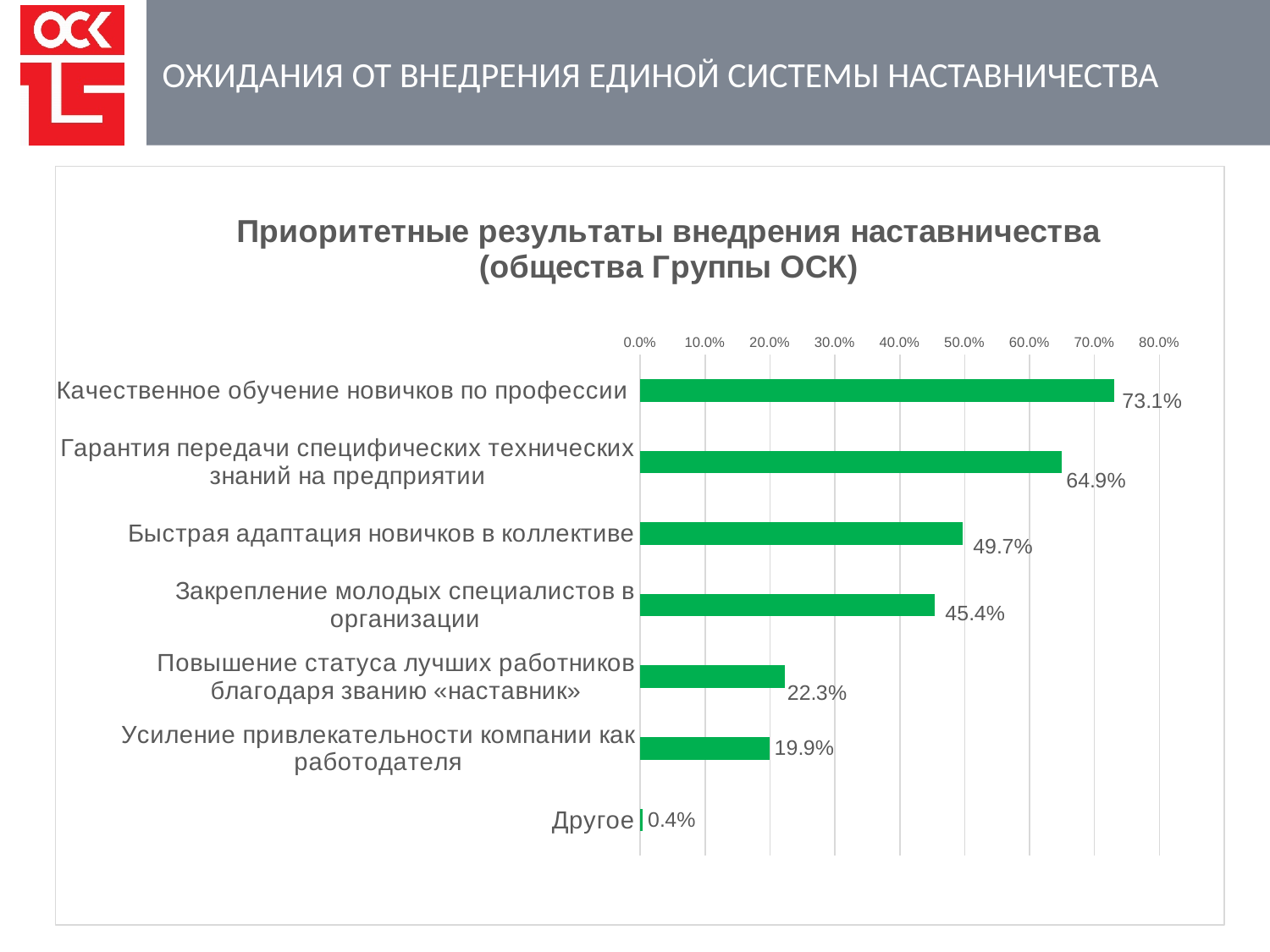
What colour are the bars in the chart? green What is the value for «Быстрая адаптация новичков в коллективе»? 49.7% What is the difference between «Гарантия передачи специфических технических знаний на предприятии» and «Закрепление молодых специалистов в организации»? 19.5% Which category has the lowest value? Другое What is the value for «Усиление привлекательности компании как работодателя»? 19.9% What is the value for «Качественное обучение новичков по профессии»? 73.1% What kind of chart is shown on the slide? bar chart Which category has the highest value? Качественное обучение новичков по профессии What is the title of the chart? Приоритетные результаты внедрения наставничества (общества Группы ОСК) Is the value for «Закрепление молодых специалистов в организации» greater or less than 40.0%? greater Which is larger: «Повышение статуса лучших работников благодаря званию «наставник»» or «Усиление привлекательности компании как работодателя»? Повышение статуса лучших работников благодаря званию «наставник» How many categories are shown in the chart? 7